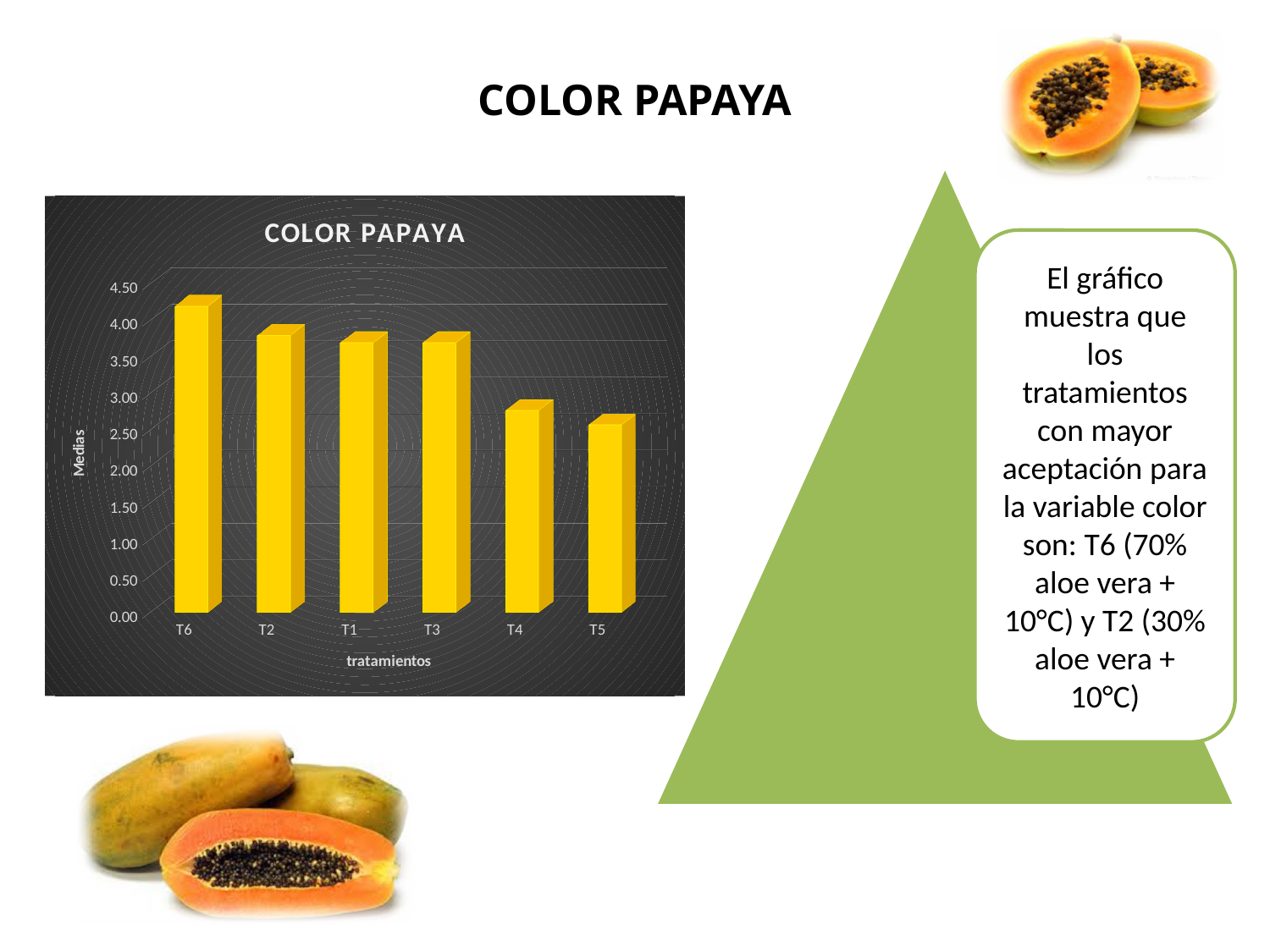
Is the value for T4 greater or less than 3.00? less Is the value for T2 greater or less than 4.00? less Which has the larger value, T2 or T5? T2 Is the value for T6 greater or less than 4.00? greater Which treatment has the highest mean value in the COLOR PAPAYA chart? T6 What kind of chart is shown on the slide? bar chart Which treatment has the lowest mean value in the COLOR PAPAYA chart? T5 Which has the larger value, T6 or T4? T6 What is the label of the vertical axis of the chart? Medias How many treatments (categories) are plotted on the x axis of the COLOR PAPAYA chart? 6 Do the bar values generally rise or fall moving from left to right along the x axis? fall